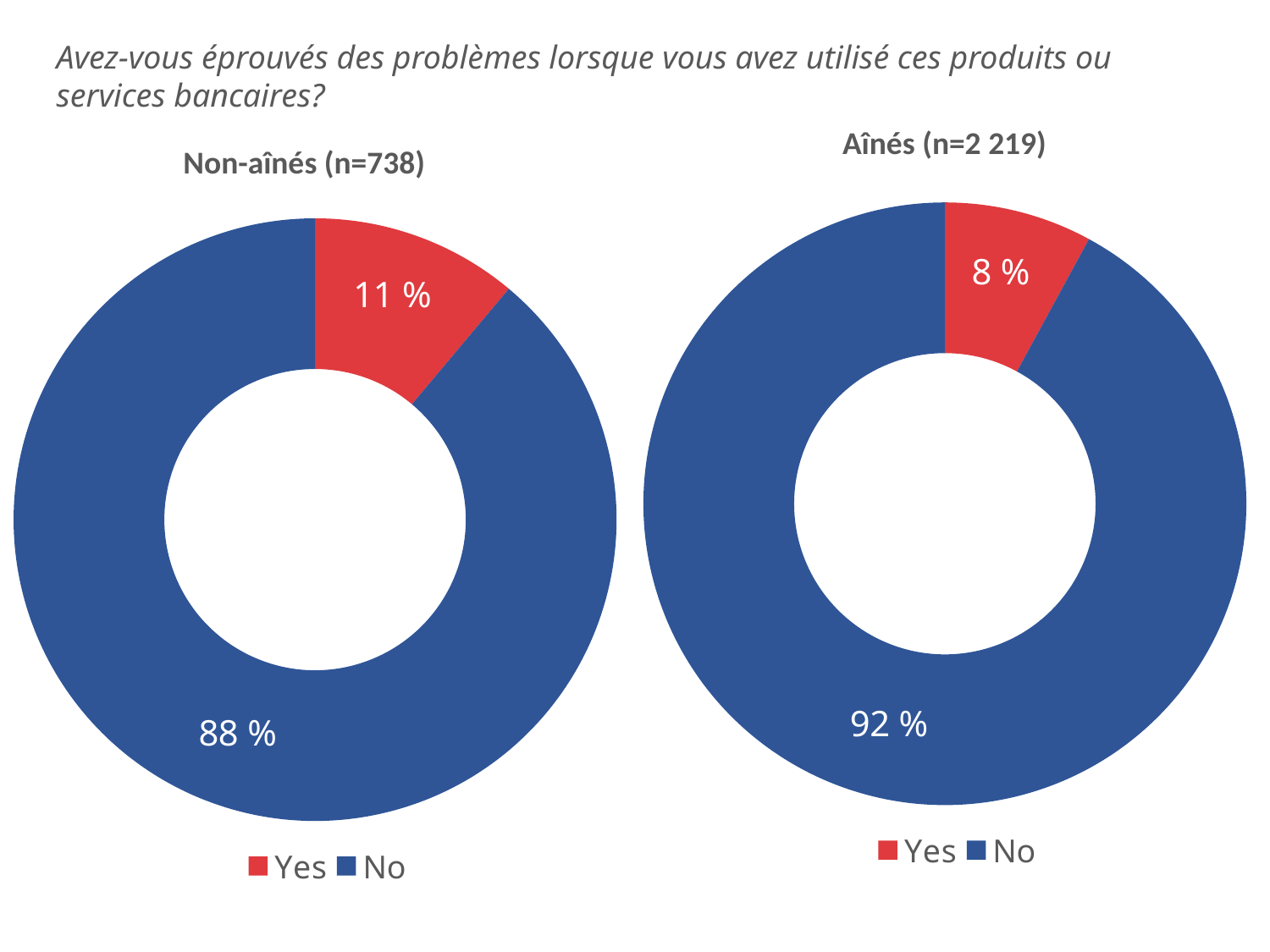
What type of chart is the 'Non-aînés (n=738)' chart? Doughnut chart What is the sample size shown in the title of the right-hand chart? n=2 219 In the 'Aînés (n=2 219)' chart, which category has the largest share? No In the 'Non-aînés (n=738)' chart, what percentage answered No? 88 % Which chart has the larger Yes share, 'Non-aînés (n=738)' or 'Aînés (n=2 219)'? Non-aînés (n=738) In the 'Non-aînés (n=738)' chart, what percentage answered Yes? 11 % In the 'Non-aînés (n=738)' chart, what colour represents the No category? Blue In the 'Aînés (n=2 219)' chart, what percentage answered No? 92 % In the 'Non-aînés (n=738)' chart, which category has the smallest share? Yes How many categories does the legend of the 'Aînés (n=2 219)' chart list? 2 In the 'Aînés (n=2 219)' chart, what percentage answered Yes? 8 % What is the difference between the No share in the 'Aînés (n=2 219)' chart and the No share in the 'Non-aînés (n=738)' chart? 4 %